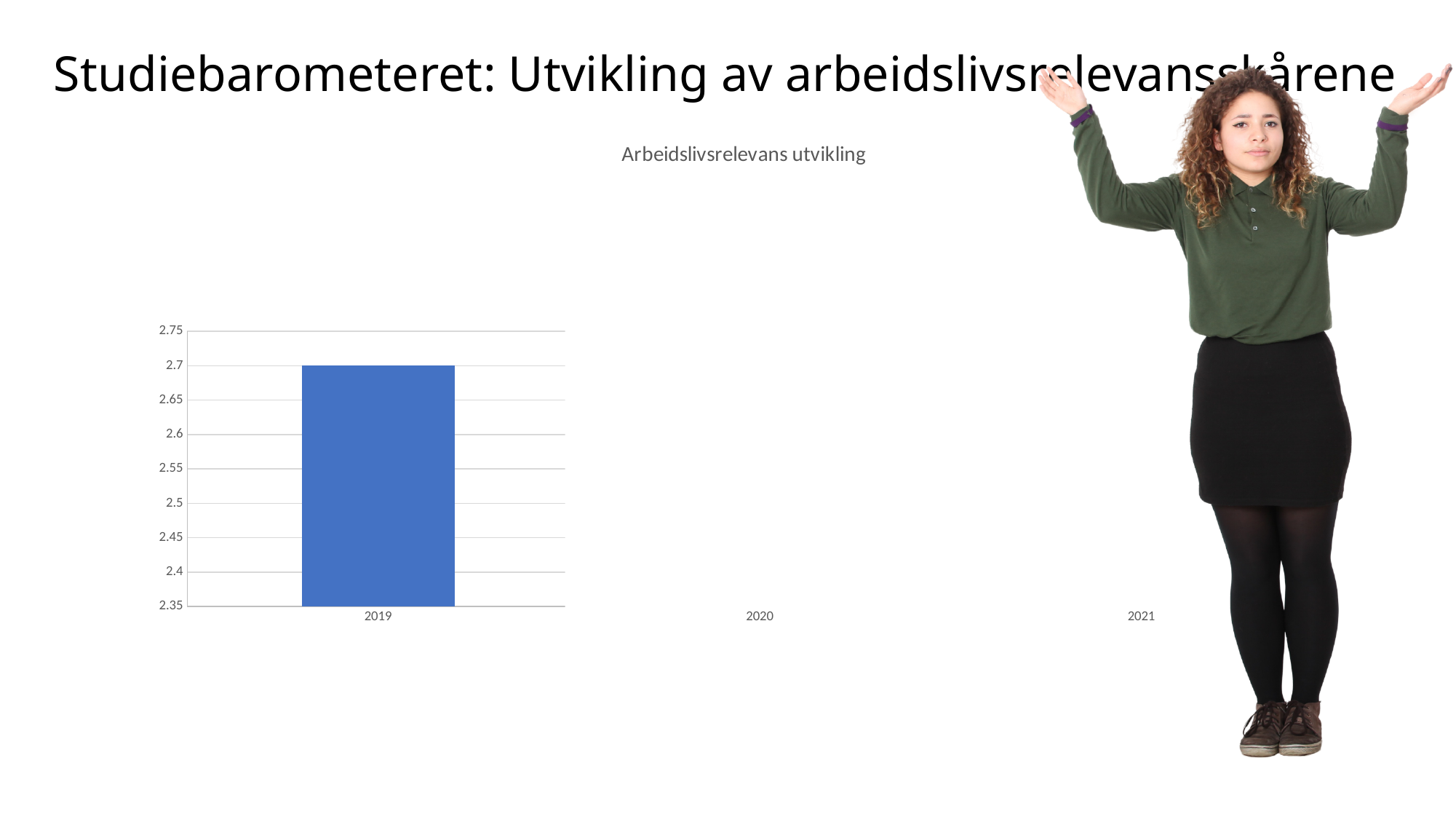
How many categories are labelled on the x axis of the chart? 3 Which year has a bar plotted in the chart? 2019 What is the highest value shown on the y axis of the chart? 2.75 How many bars are actually plotted in the chart? 1 What is the value for 2019 in the chart? 2.7 Is the value for 2019 greater or less than 2.5? greater What is the lowest value shown on the y axis of the chart? 2.35 What kind of chart is shown on the slide? bar chart Is the value for 2019 greater or less than 2.75? less What is the title of the chart? Arbeidslivsrelevans utvikling